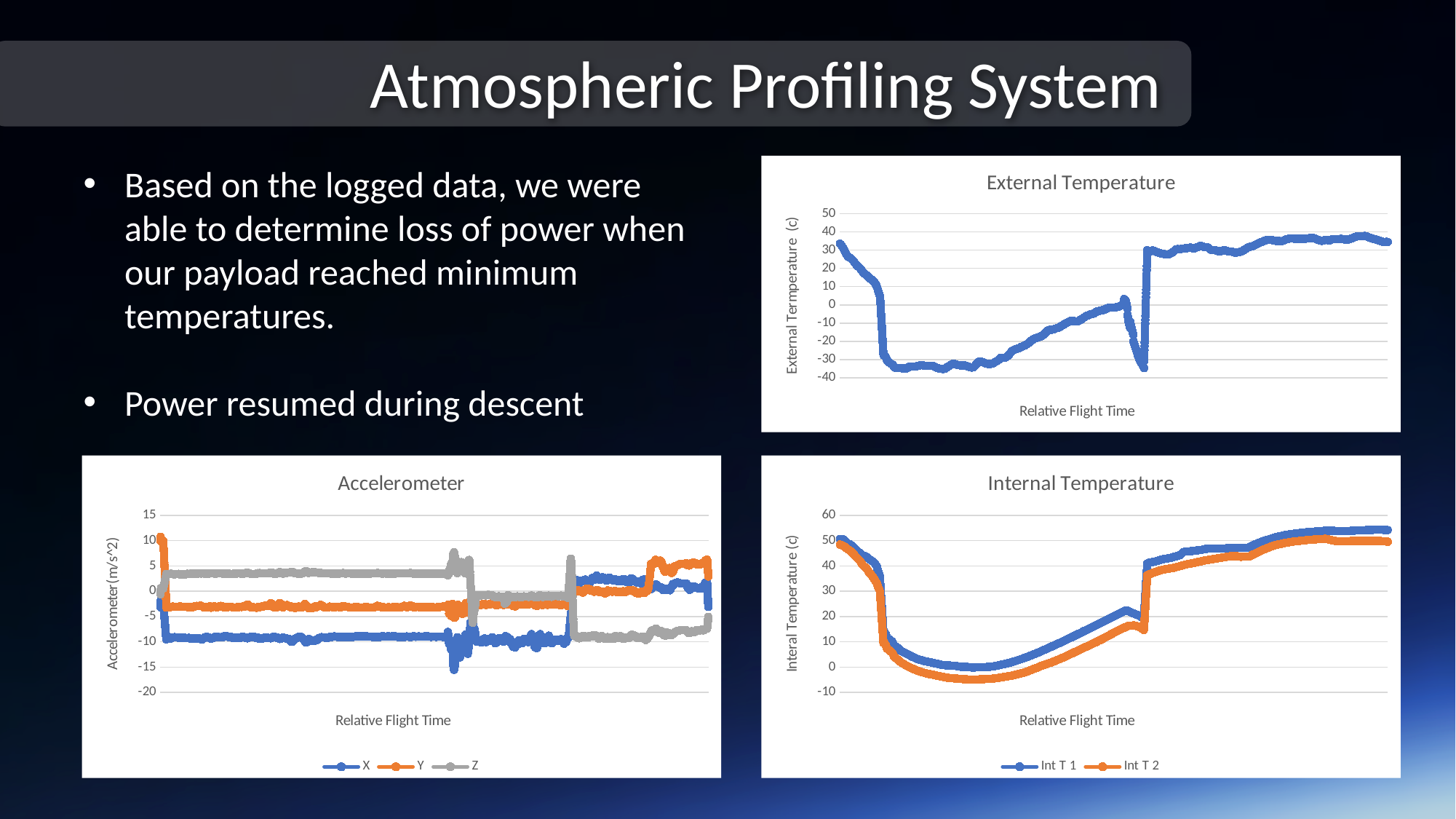
What are the series names in the legend of the Internal Temperature chart? Int T 1, Int T 2 In the External Temperature chart, is the lowest value reached greater or less than -30? less In the Internal Temperature chart, which series has the higher value at the end of the flight, Int T 1 or Int T 2? Int T 1 What kind of chart is the External Temperature chart? line chart How many series does the legend of the Internal Temperature chart list? 2 In the Internal Temperature chart, is the final value of Int T 1 greater or less than 50? greater In the External Temperature chart, is the value at the end of the flight greater or less than 20? greater In the Accelerometer chart, which series has the highest value during the first part of the flight, X, Y or Z? Z What is the x-axis label of the Accelerometer chart? Relative Flight Time How many series does the legend of the Accelerometer chart list? 3